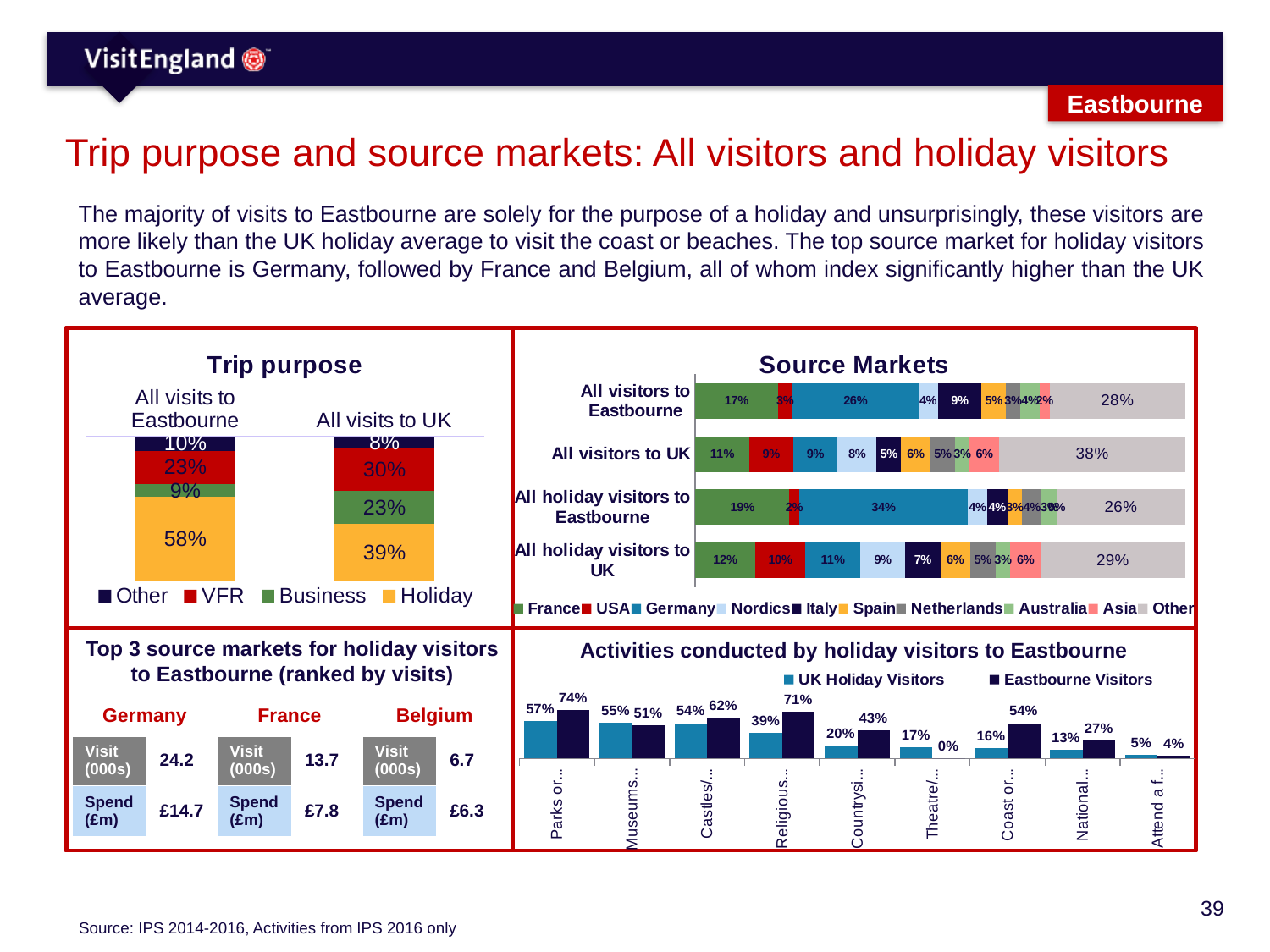
In the Trip purpose chart, what share of all visits to Eastbourne are for Holiday? 58% In the Activities conducted by holiday visitors to Eastbourne chart, what is the Eastbourne Visitors value for Religious sites? 71% In the Activities conducted by holiday visitors to Eastbourne chart, what is the difference between Eastbourne Visitors and UK Holiday Visitors for Coast? 38 percentage points In the Trip purpose chart, what share of all visits to UK are VFR? 30% In the Trip purpose chart, what is the difference between the Business share for all visits to UK and for all visits to Eastbourne? 14 percentage points What kind of chart is the Activities conducted by holiday visitors to Eastbourne chart? Bar chart In the Source Markets chart, which category has the largest Germany share? All holiday visitors to Eastbourne In the Source Markets chart, what share of all holiday visitors to Eastbourne come from Germany? 34% In the Source Markets chart, what share of all visitors to UK fall under Other? 38% How many series does the legend of the Trip purpose chart list? 4 In the Activities conducted by holiday visitors to Eastbourne chart, which is larger for Museums: UK Holiday Visitors or Eastbourne Visitors? UK Holiday Visitors How many series does the legend of the Source Markets chart list? 10